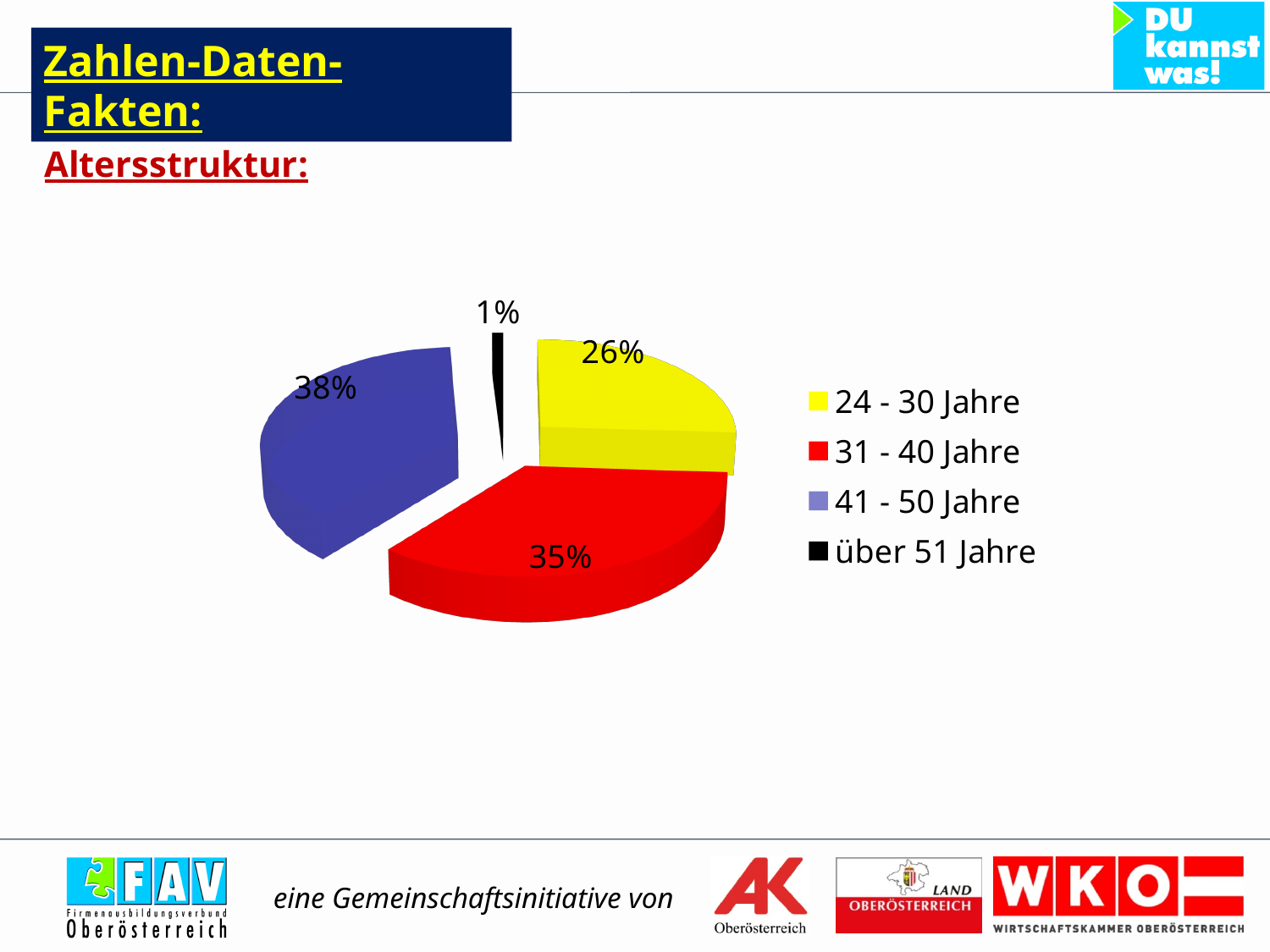
How many slices does the pie chart have? 4 What colour is the slice for 31 - 40 Jahre? Red What share of the pie does the 41 - 50 Jahre slice represent? 38% Which slice is larger: 31 - 40 Jahre or 24 - 30 Jahre? 31 - 40 Jahre What share of the pie does the über 51 Jahre slice represent? 1% Which age group has the smallest share of the pie? über 51 Jahre Which age group has the largest share of the pie? 41 - 50 Jahre What share of the pie does the 24 - 30 Jahre slice represent? 26% What kind of chart is shown on the slide? Pie chart What is the difference in percentage points between the 41 - 50 Jahre slice and the 24 - 30 Jahre slice? 12 How many entries does the legend list? 4 What share of the pie does the 31 - 40 Jahre slice represent? 35%